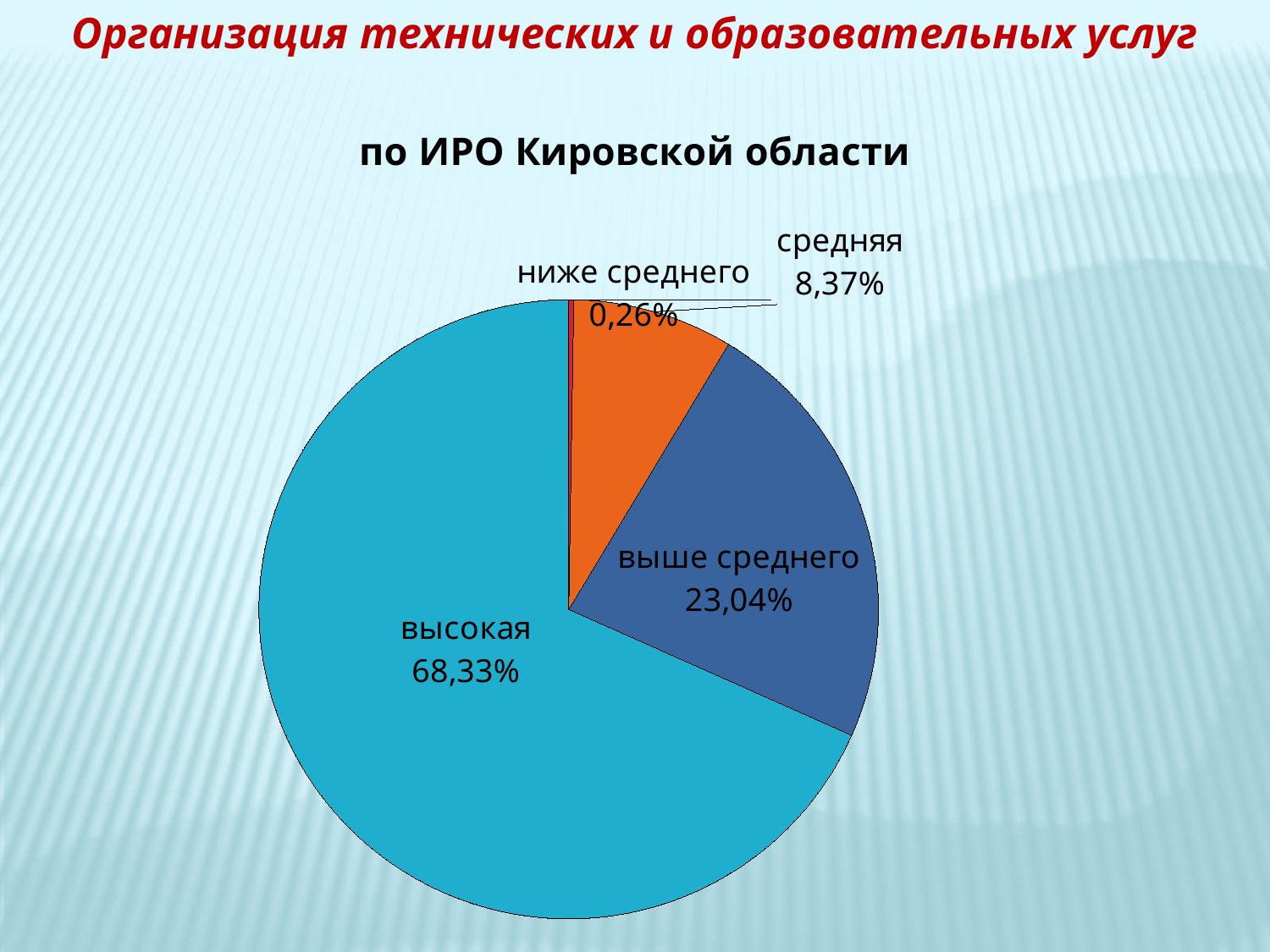
What is the value for the "ниже среднего" slice? 0,26% Which is larger, the share for "выше среднего" or the share for "средняя"? выше среднего What is the title of the chart? по ИРО Кировской области What is the value for the "высокая" slice? 68,33% Which category has the smallest share of the pie? ниже среднего What is the difference between the shares for "высокая" and "выше среднего"? 45,29% What is the value for the "средняя" slice? 8,37% How many slices does the pie chart have? 4 Which category has the largest share of the pie? высокая What kind of chart is shown on the slide? pie chart What is the difference between the shares for "средняя" and "ниже среднего"? 8,11% What is the value for the "выше среднего" slice? 23,04%